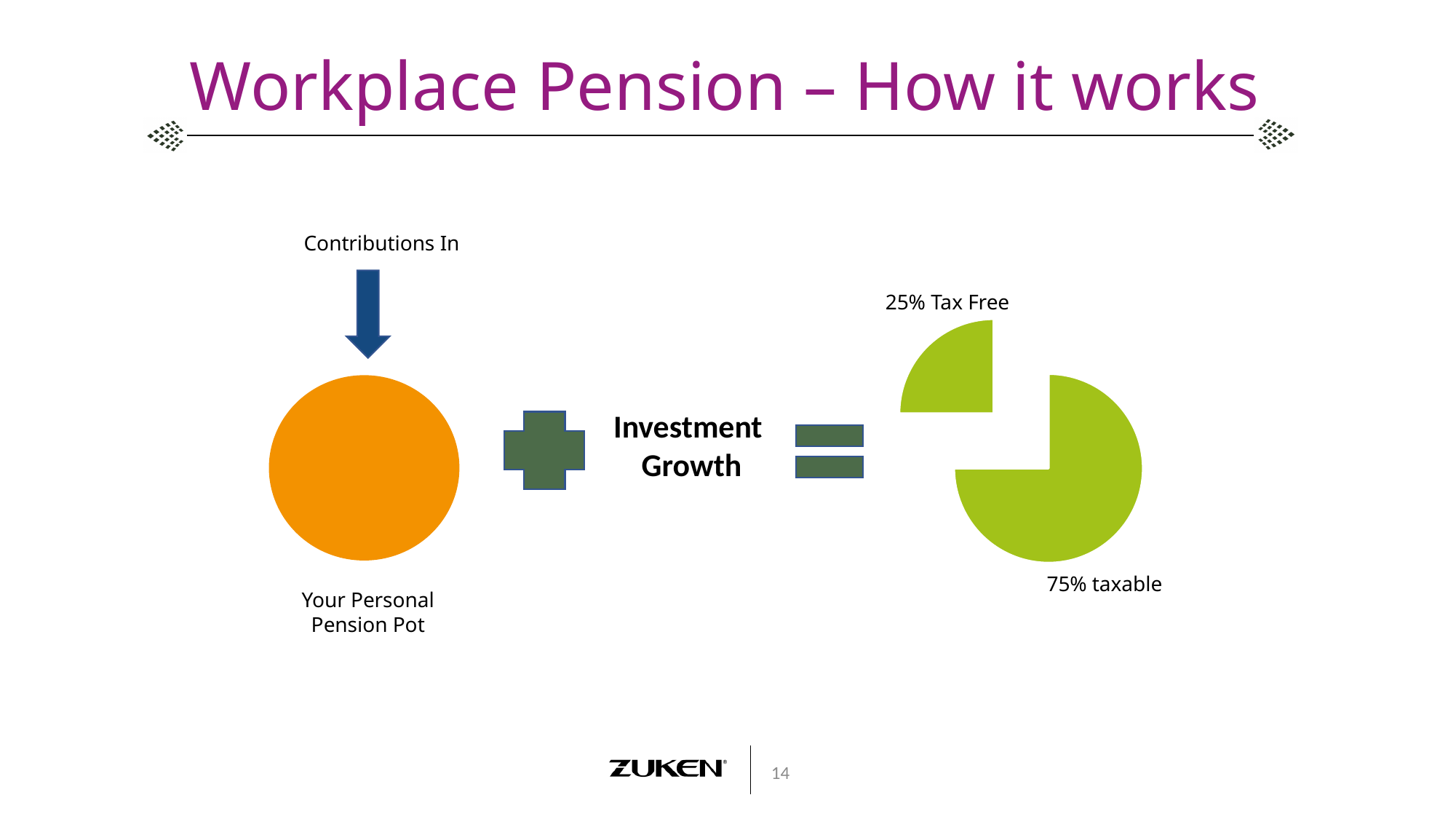
What is the title of the slide containing the pie? Workplace Pension – How it works How many slices does the pie on the right have? 2 What share of the pension pot is labelled as tax free in the pie on the right? 25% What share of the pension pot is labelled as taxable in the pie on the right? 75% Which slice of the pie on the right is the smallest? The tax free slice What colour are the slices of the pie on the right? Green What kind of chart is shown on the right of the slide? Pie chart Which slice of the pie on the right is larger, the tax free slice or the taxable slice? The taxable slice What is the difference between the taxable share and the tax free share in the pie on the right? 50% What is the total of the two slices in the pie on the right? 100%